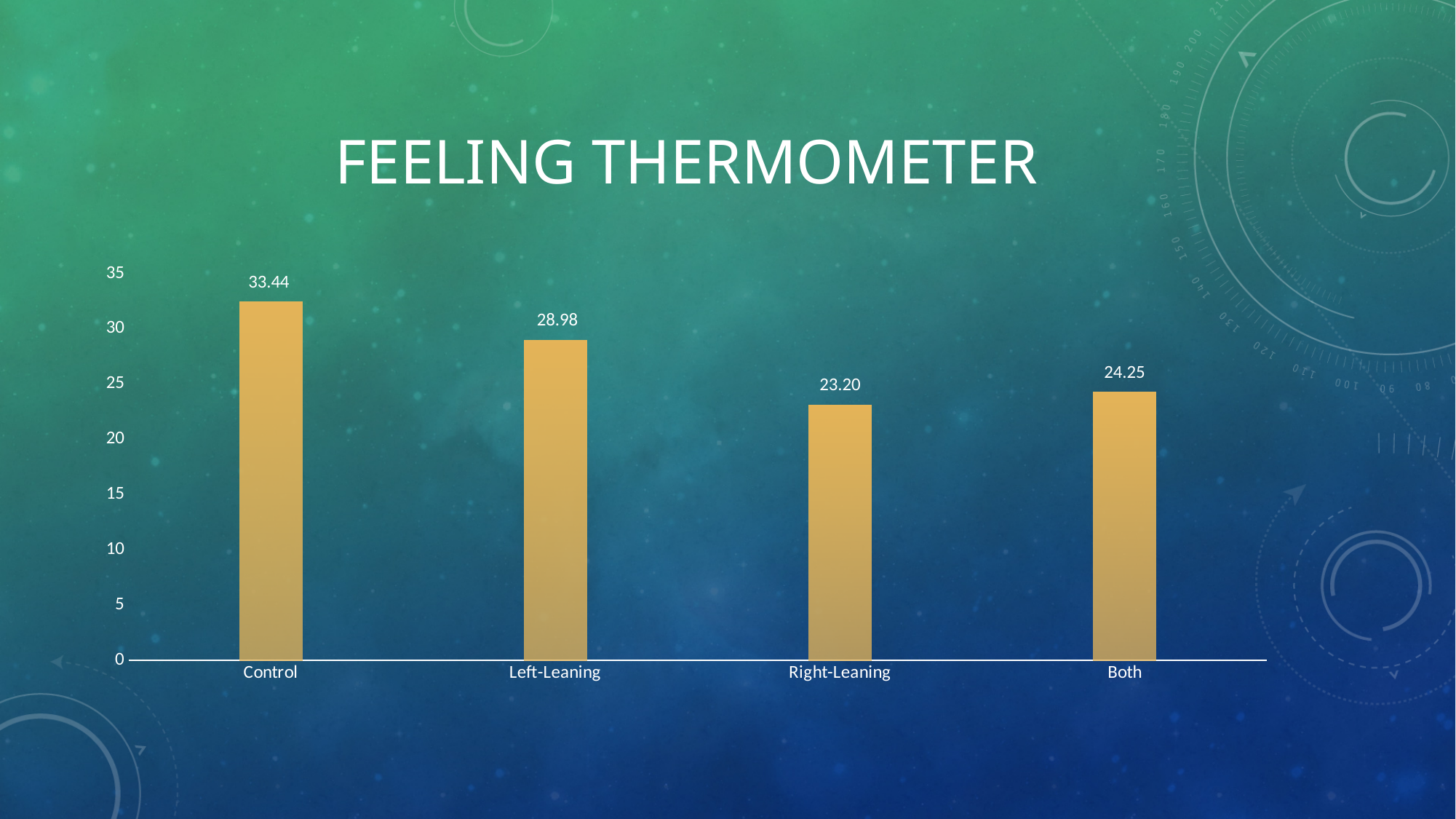
What is the value for Left-Leaning? 28.98 What is the value for Right-Leaning? 23.20 What is the difference between the values for Both and Right-Leaning? 1.05 Which is larger, the value for Left-Leaning or the value for Both? Left-Leaning What kind of chart is shown on the slide? bar chart How many categories are shown on the x axis? 4 What is the value for Both? 24.25 Which category has the highest value? Control Which category has the lowest value? Right-Leaning What is the value for Control? 33.44 Is the value for Right-Leaning greater or less than 25? less What is the difference between the values for Control and Left-Leaning? 4.46